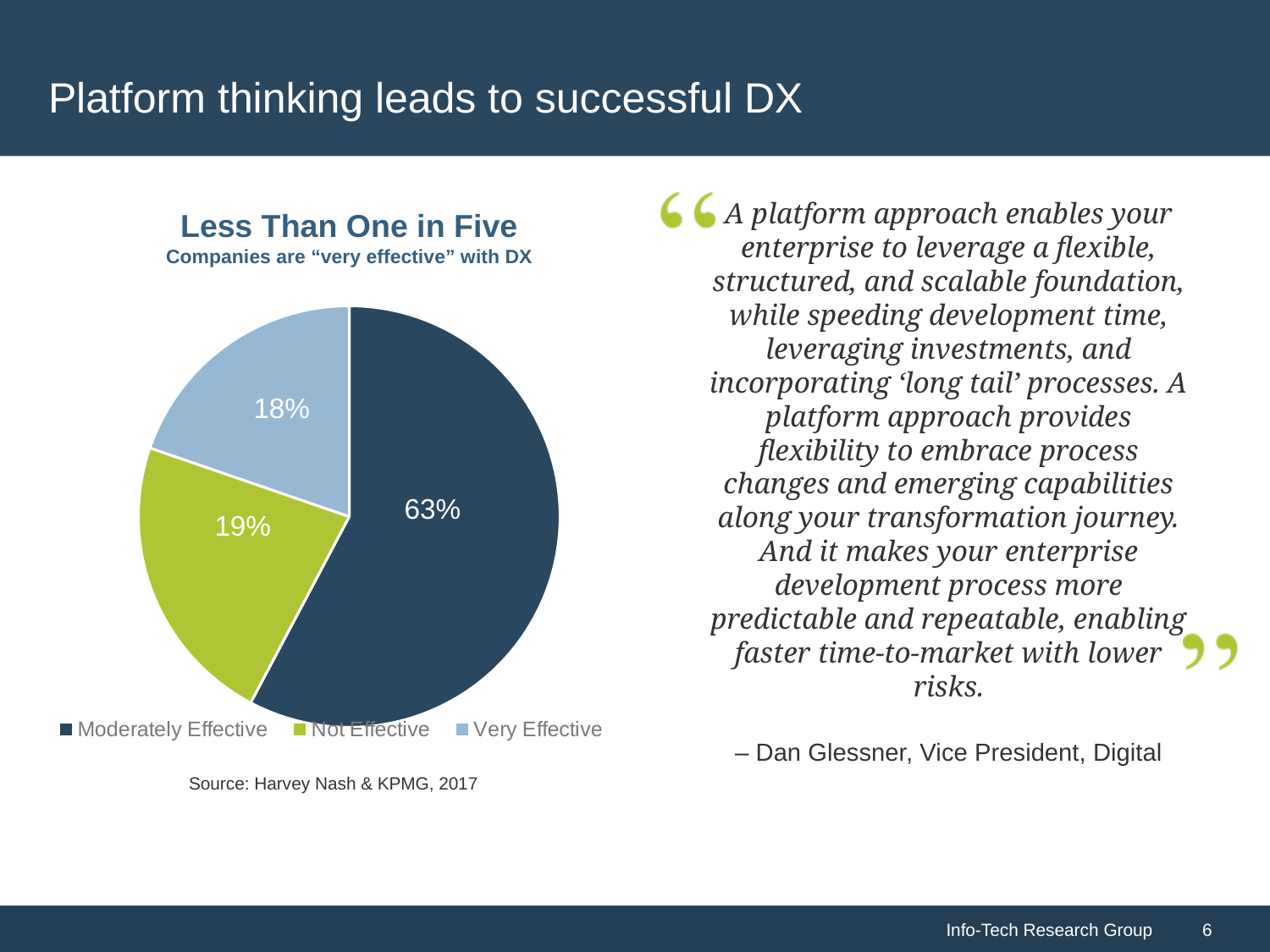
What percentage of companies are Very Effective with DX? 18% What kind of chart is shown on the slide? pie chart What is the difference in percentage points between Moderately Effective and Very Effective? 45 What is the difference in percentage points between Not Effective and Very Effective? 1 What percentage of companies are Not Effective with DX? 19% What is the title of the pie chart? Less Than One in Five Which is larger, the share for Moderately Effective or the share for Not Effective? Moderately Effective How many entries does the legend list? 3 What percentage of companies are Moderately Effective with DX? 63% How many slices does the pie chart have? 3 Which category has the largest share of the pie? Moderately Effective Which category has the smallest share of the pie? Very Effective